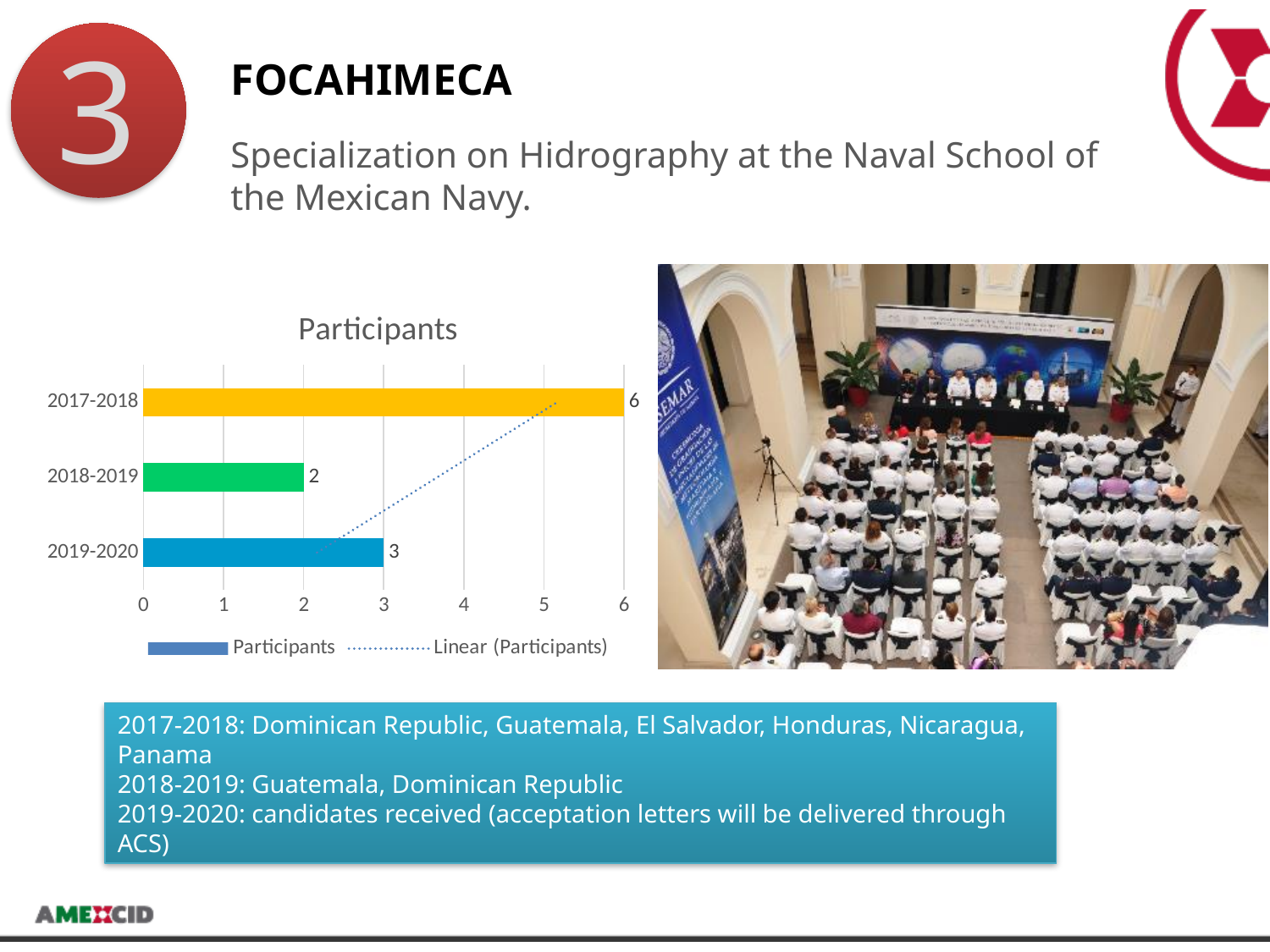
Which period has the highest number of participants? 2017-2018 What is the value for 2017-2018 in the Participants chart? 6 How many periods are shown in the Participants chart? 3 Which period has the lowest number of participants? 2018-2019 How many entries does the legend of the Participants chart list? 2 What is the value for 2018-2019 in the Participants chart? 2 Which has more participants, 2018-2019 or 2019-2020? 2019-2020 What is the difference in participants between 2017-2018 and 2019-2020? 3 What is the title of the chart on the slide? Participants What is the difference in participants between 2019-2020 and 2018-2019? 1 What kind of chart is the Participants chart? bar chart What is the value for 2019-2020 in the Participants chart? 3